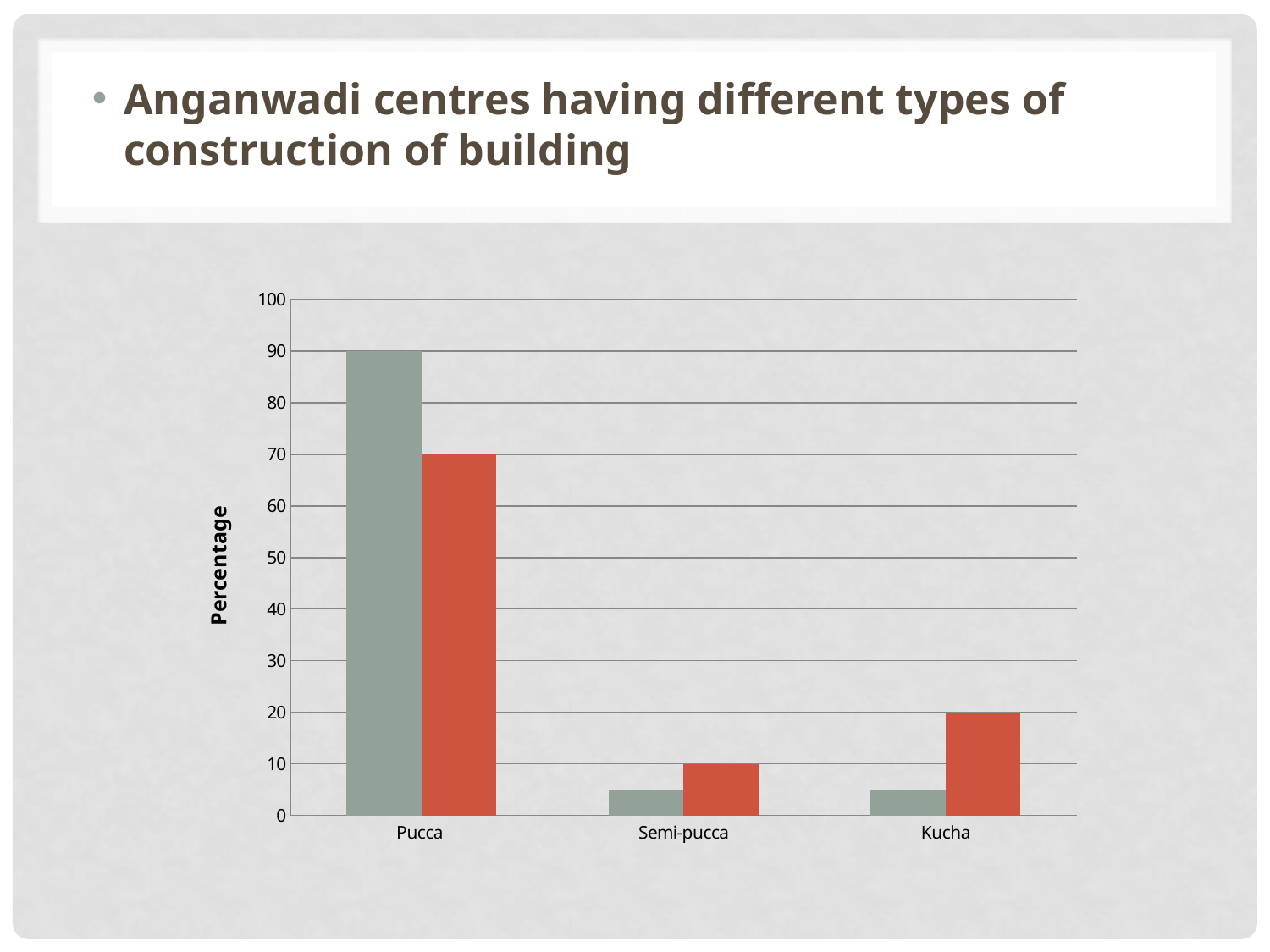
Which has the larger red bar, Kucha or Semi-pucca? Kucha What is the value of the red bar for Kucha? 20 Is the value of the grey bar for Semi-pucca greater or less than 10? less What is the value of the red bar for Semi-pucca? 10 What is the value of the red bar for Pucca? 70 What is the title of the vertical axis of the chart? Percentage Which category has the lowest red bar? Semi-pucca How many categories are shown on the x axis of the chart? 3 What is the value of the grey bar for Pucca? 90 What type of chart is shown on the slide? bar chart Which category has the highest grey bar? Pucca What is the difference between the grey bar and the red bar for Pucca? 20